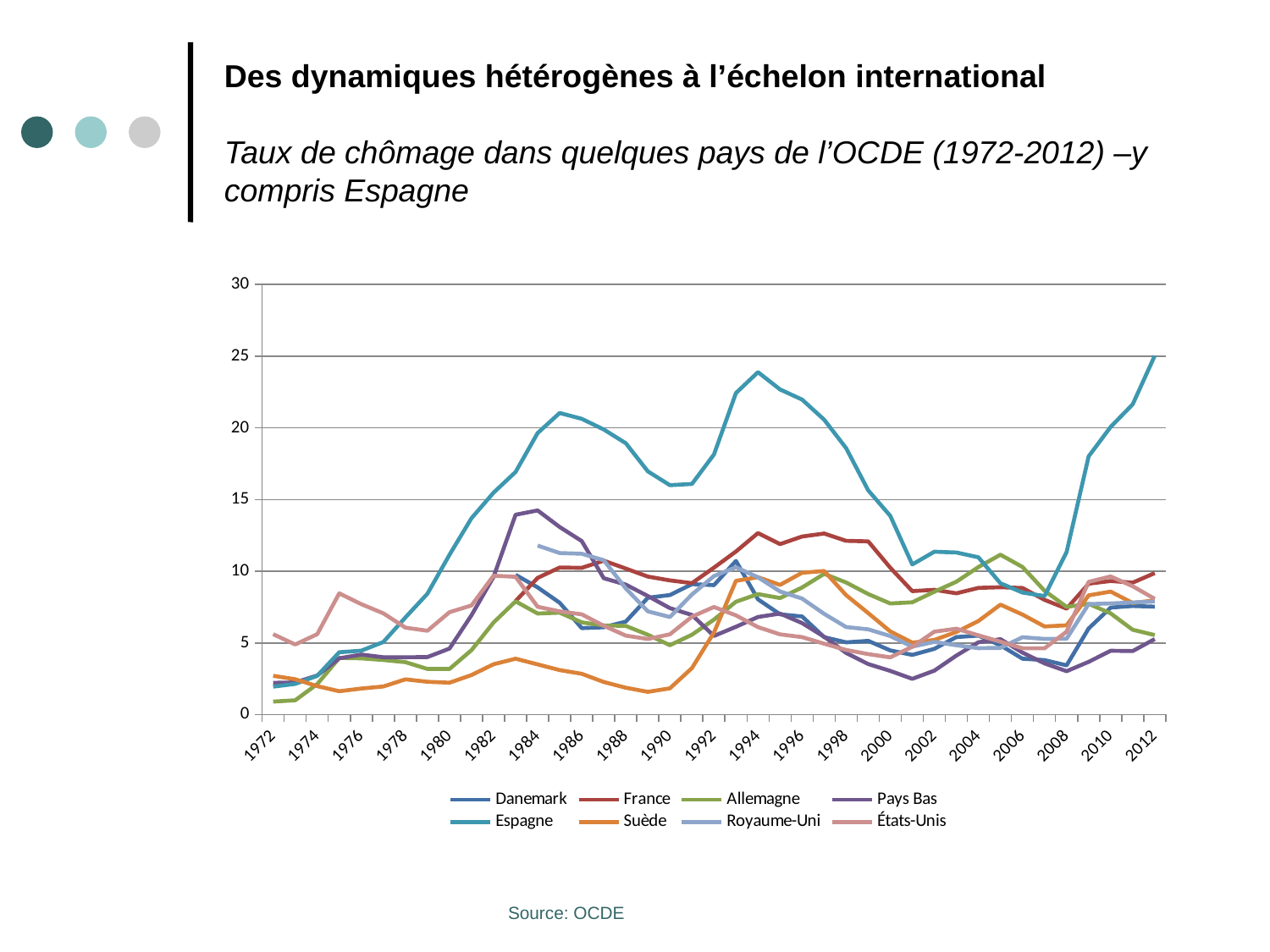
Is the value for Suède in 1990 greater or less than 5? less Does the unemployment rate for Espagne rise or fall between 2008 and 2012? rise Which country has the lowest unemployment rate in 1990? Suède Is the value for Espagne in 1972 greater or less than 5? less In 2012, which country has the higher unemployment rate, France or Allemagne? France What type of chart is shown on the slide? line chart What source is cited below the chart? OCDE Which country has the highest unemployment rate in 2012? Espagne In 1984, which country has the higher unemployment rate, Pays Bas or Suède? Pays Bas How many countries (series) does the legend list? 8 Is the value for Espagne in 2012 greater or less than 20? greater Which country has the highest unemployment rate in 1994? Espagne